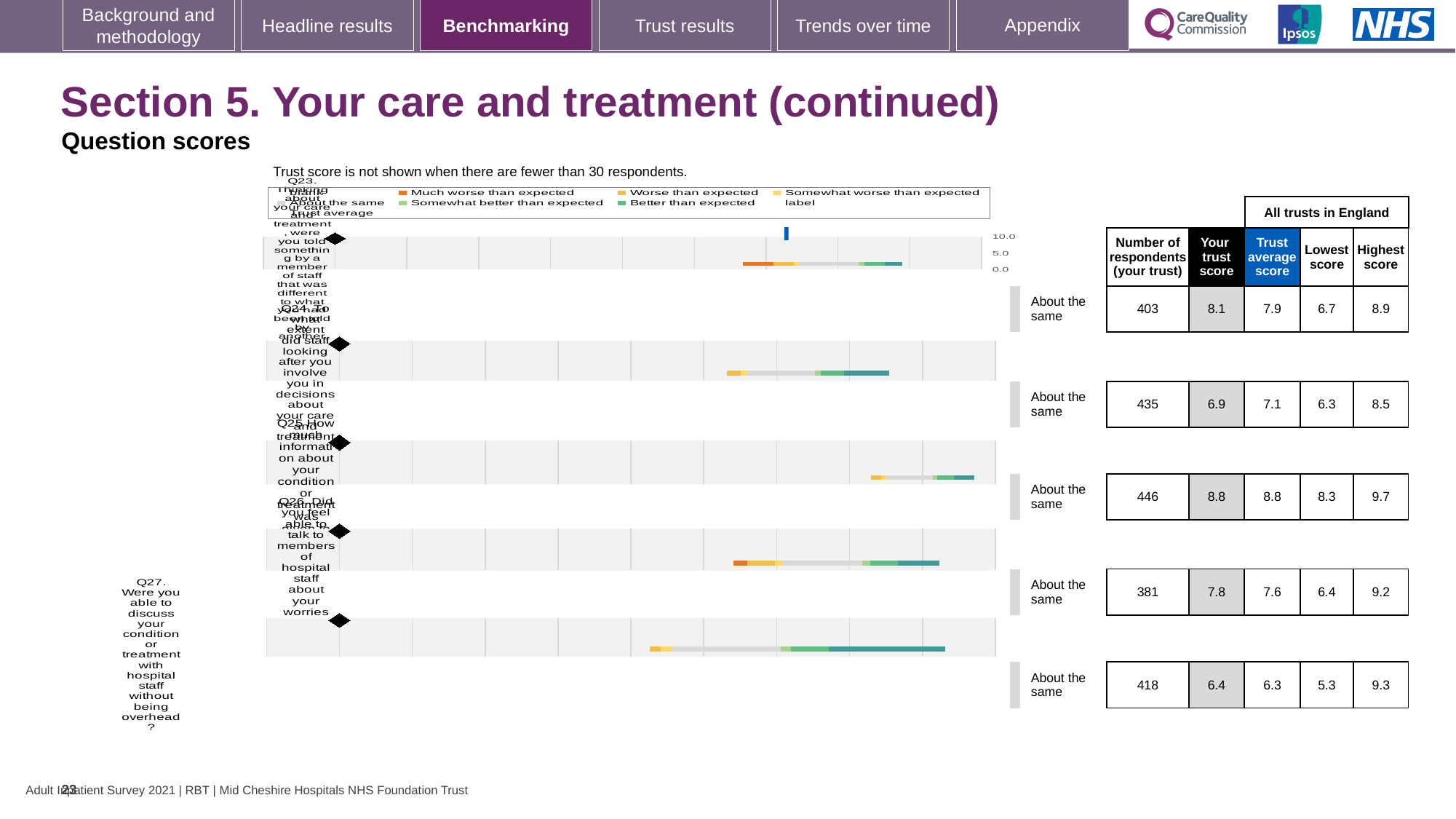
What is the trust score for Q25 (How much information about your condition or treatment was given to you)? 8.8 What is the trust average score for Q24 (To what extent did staff looking after you involve you in decisions about your care and treatment)? 7.1 Which question has the highest number of respondents? Q25 Which question has the lowest 'Your trust score' value? Q27 What is the lowest score across all trusts in England for Q27? 5.3 What is the benchmark category shown for Q26? About the same What is the highest score across all trusts in England for Q26 (Did you feel able to talk to members of hospital staff about your worries)? 9.2 How many questions are plotted in the chart? 5 Is the trust score for Q24 larger or smaller than the trust average score for Q24? smaller What is the number of respondents for Q27 (Were you able to discuss your condition or treatment with hospital staff without being overheard)? 418 What type of chart is used to show the question scores? bar chart What is the difference between the trust score and the trust average score for Q23? 0.2